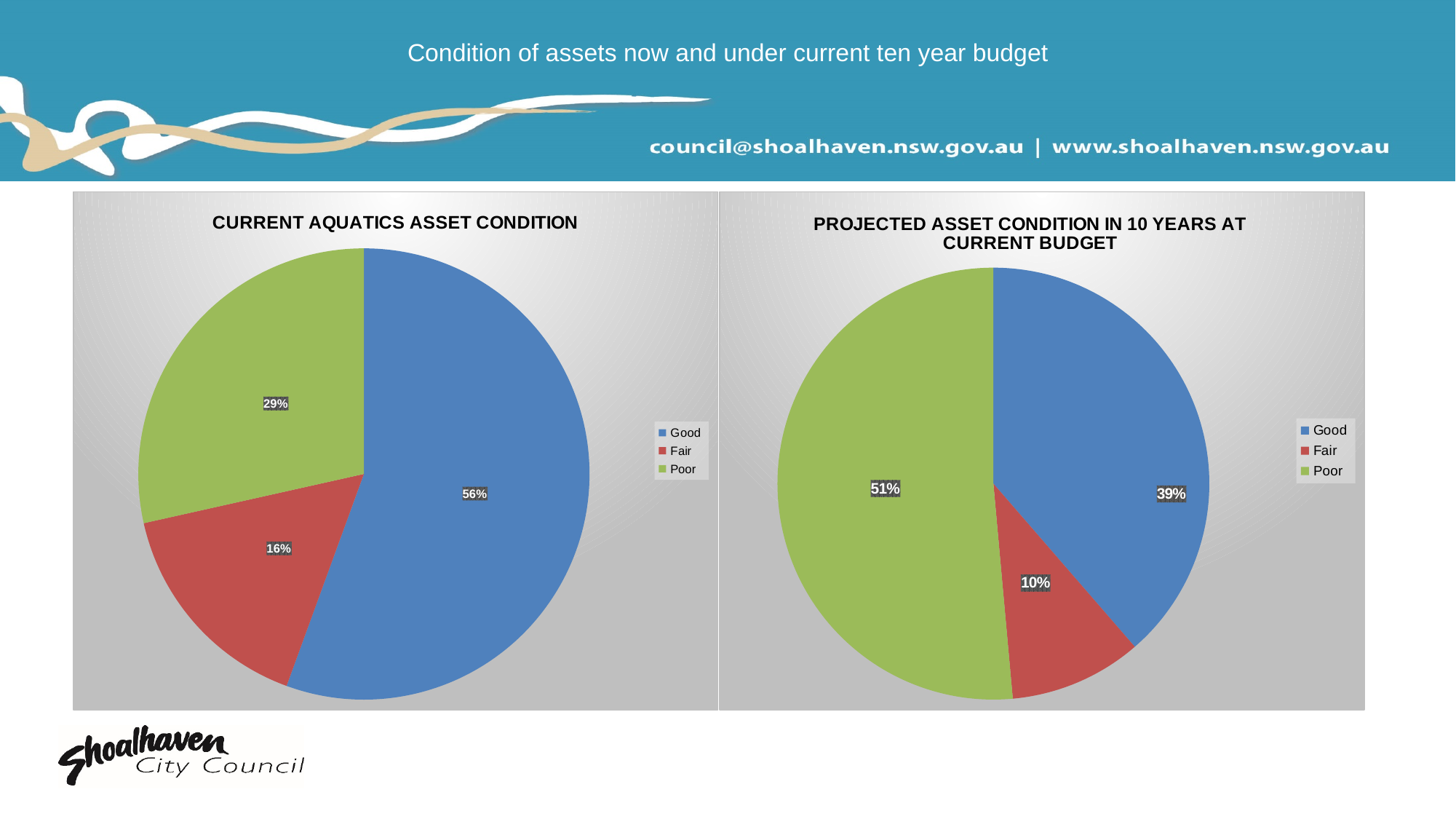
In the 'CURRENT AQUATICS ASSET CONDITION' chart, what share of assets is in Good condition? 56% In the 'PROJECTED ASSET CONDITION IN 10 YEARS AT CURRENT BUDGET' chart, what share of assets is projected to be in Good condition? 39% In the 'PROJECTED ASSET CONDITION IN 10 YEARS AT CURRENT BUDGET' chart, which condition category has the smallest share? Fair In the 'CURRENT AQUATICS ASSET CONDITION' chart, what share of assets is in Fair condition? 16% How many categories does the legend of the 'PROJECTED ASSET CONDITION IN 10 YEARS AT CURRENT BUDGET' chart list? 3 In the 'CURRENT AQUATICS ASSET CONDITION' chart, which condition category has the largest share? Good What type of chart is the 'CURRENT AQUATICS ASSET CONDITION' chart? Pie chart What is the difference between the Good share in the 'CURRENT AQUATICS ASSET CONDITION' chart and the Good share in the 'PROJECTED ASSET CONDITION IN 10 YEARS AT CURRENT BUDGET' chart? 17% In the 'PROJECTED ASSET CONDITION IN 10 YEARS AT CURRENT BUDGET' chart, which is larger: the Poor share or the Good share? Poor In the 'PROJECTED ASSET CONDITION IN 10 YEARS AT CURRENT BUDGET' chart, what share of assets is projected to be in Fair condition? 10% In the 'PROJECTED ASSET CONDITION IN 10 YEARS AT CURRENT BUDGET' chart, what share of assets is projected to be in Poor condition? 51% In the 'CURRENT AQUATICS ASSET CONDITION' chart, what share of assets is in Poor condition? 29%